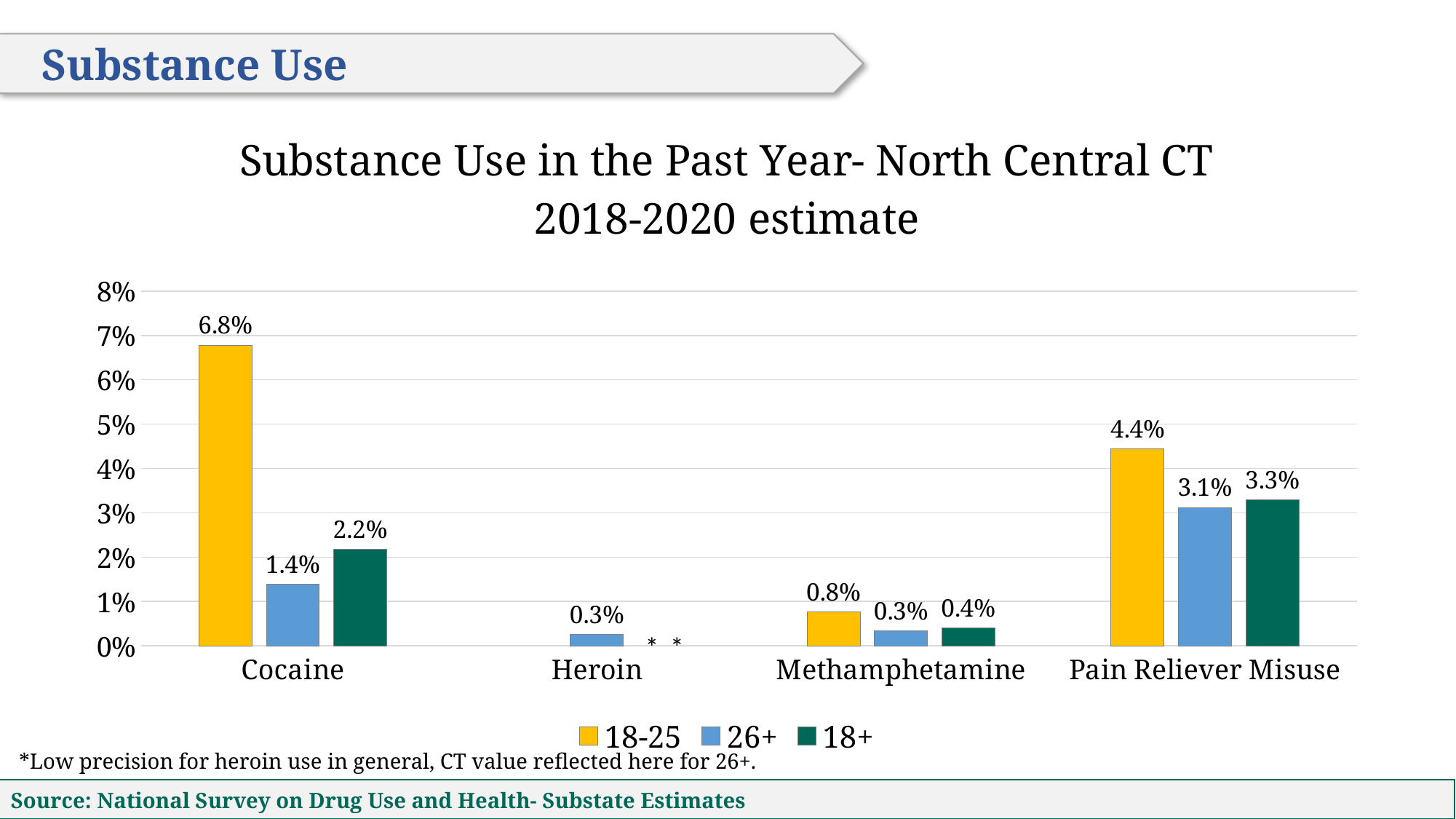
Which category has the lowest value for the 18+ series among those with a printed value? Methamphetamine What is the difference between the 18-25 and 26+ values for Cocaine? 5.4% What is the value for the 26+ series for Pain Reliever Misuse? 3.1% How many series does the legend list? 3 What is the value for the 18-25 series for Cocaine? 6.8% What is the value for the 26+ series for Heroin? 0.3% Is the 18-25 value for Pain Reliever Misuse greater or less than 4%? greater What kind of chart is shown on the slide? Bar chart Which is larger for Pain Reliever Misuse, the 26+ value or the 18+ value? 18+ Which category has the highest value for the 18-25 series? Cocaine What is the value for the 18+ series for Methamphetamine? 0.4% How many substance categories are shown on the x axis? 4